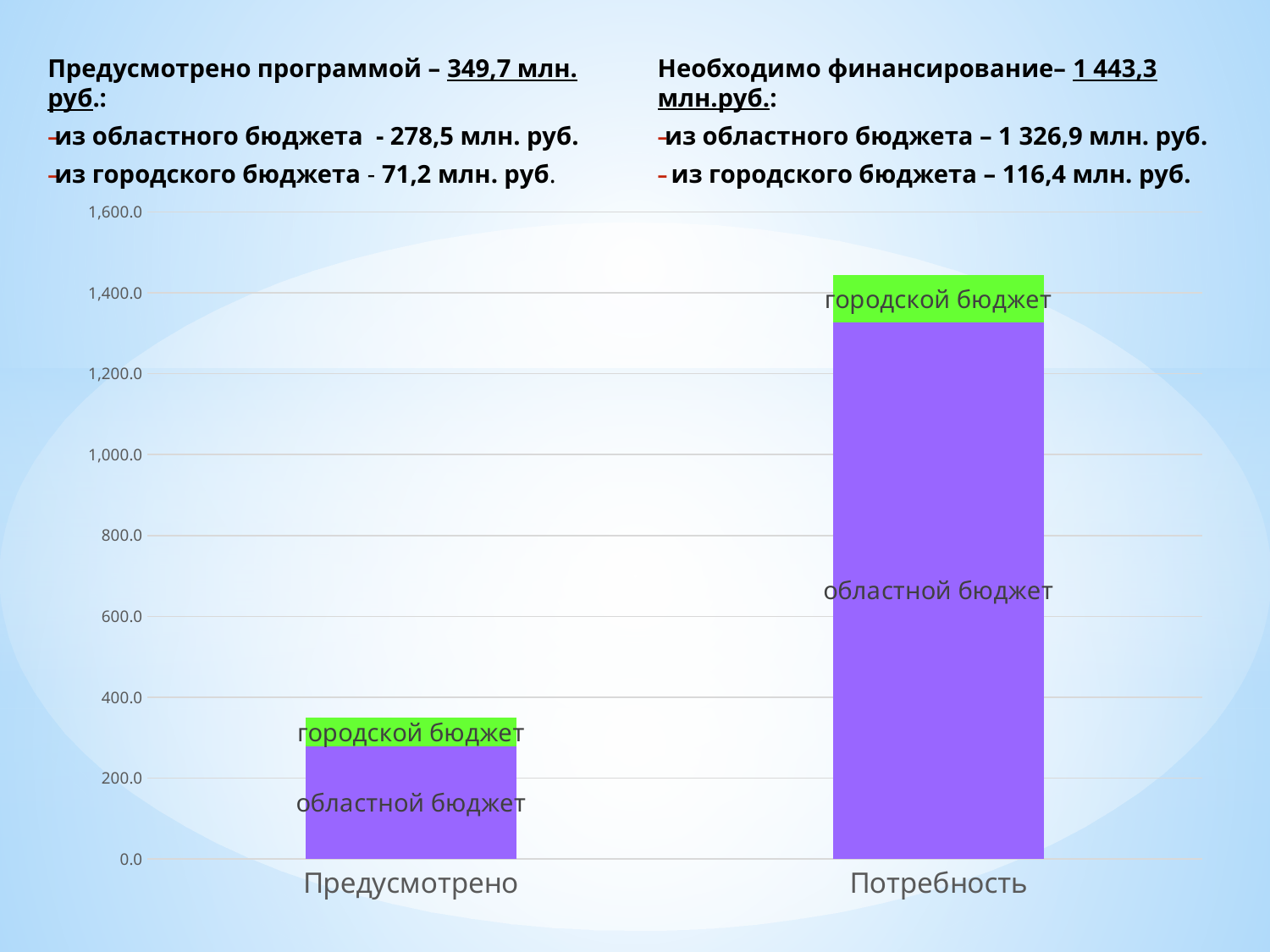
Is the total of the Предусмотрено bar greater or less than 400.0? less Is the областной бюджет segment of the Потребность bar greater or less than 1,200.0? greater According to the slide text, what is the total value of the Потребность bar? 1 443,3 млн.руб. How many categories are shown on the x axis of the chart? 2 How many segments (series) make up each stacked bar in the chart? 2 Is the total of the Потребность bar greater or less than 1,400.0? greater What kind of chart is shown on the slide? stacked bar chart Which colour represents городской бюджет in the chart? green Which category has the shorter stacked bar? Предусмотрено According to the slide text, what is the областной бюджет value for Потребность? 1 326,9 млн. руб. According to the slide text, what is the total value of the Предусмотрено bar? 349,7 млн. руб. Which category has the taller stacked bar, Предусмотрено or Потребность? Потребность